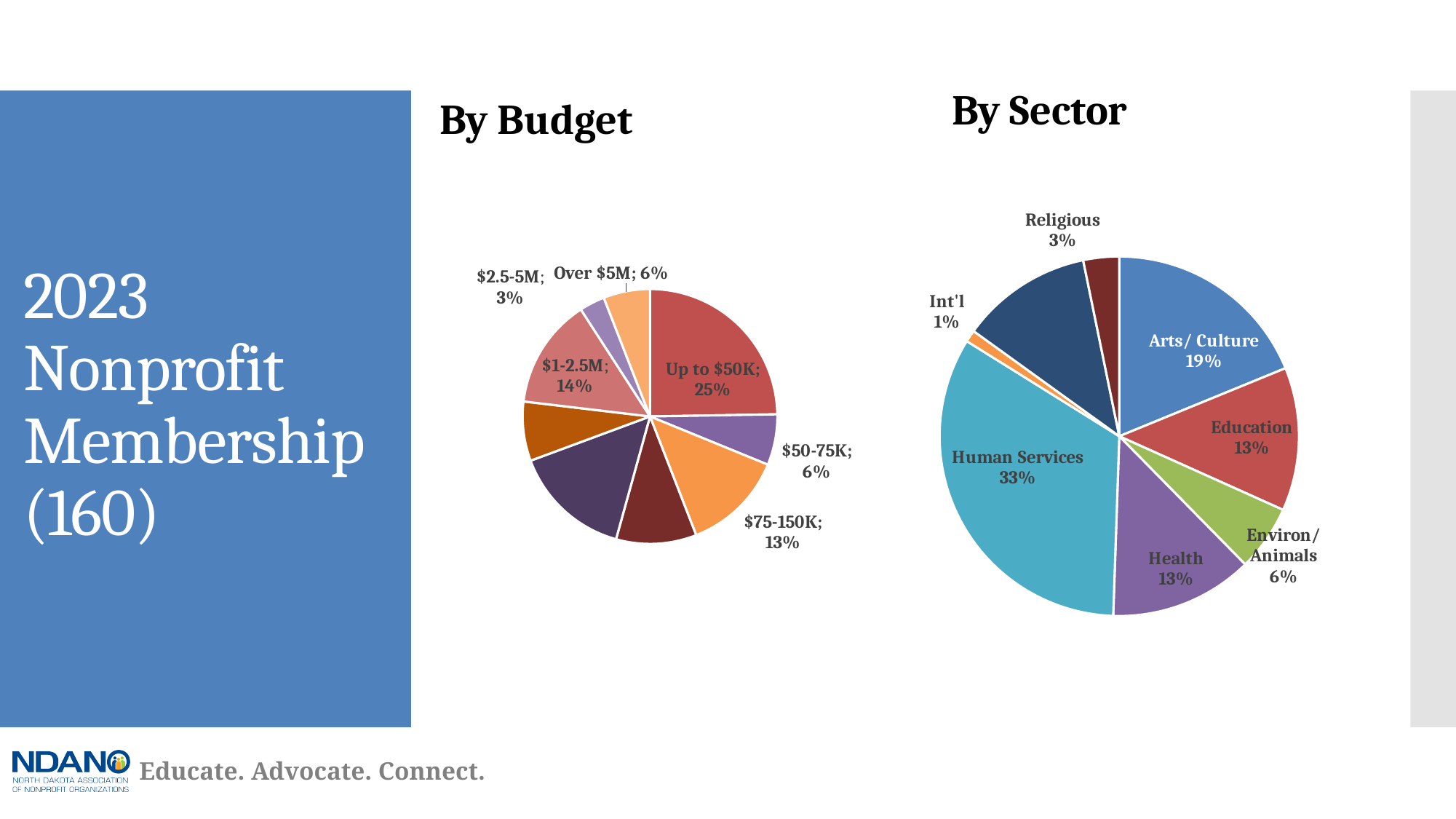
In the By Budget chart, what share of members have a budget of up to $50K? 25% In the By Budget chart, what percentage of members have a budget over $5M? 6% In the By Budget chart, what percentage of members have a budget of $1-2.5M? 14% In the By Sector chart, how many slices does the pie have? 8 In the By Sector chart, which sector has the largest share? Human Services In the By Budget chart, which labeled budget category has the smallest share? $2.5-5M In the By Sector chart, what percentage of members are in Human Services? 33% In the By Sector chart, which is larger: Education or Environ/Animals? Education What type of chart is the By Sector chart? Pie chart In the By Budget chart, what is the difference between the Up to $50K share and the $75-150K share? 12% In the By Sector chart, which sector has the smallest share? Int'l In the By Sector chart, what percentage of members are in Arts/Culture? 19%